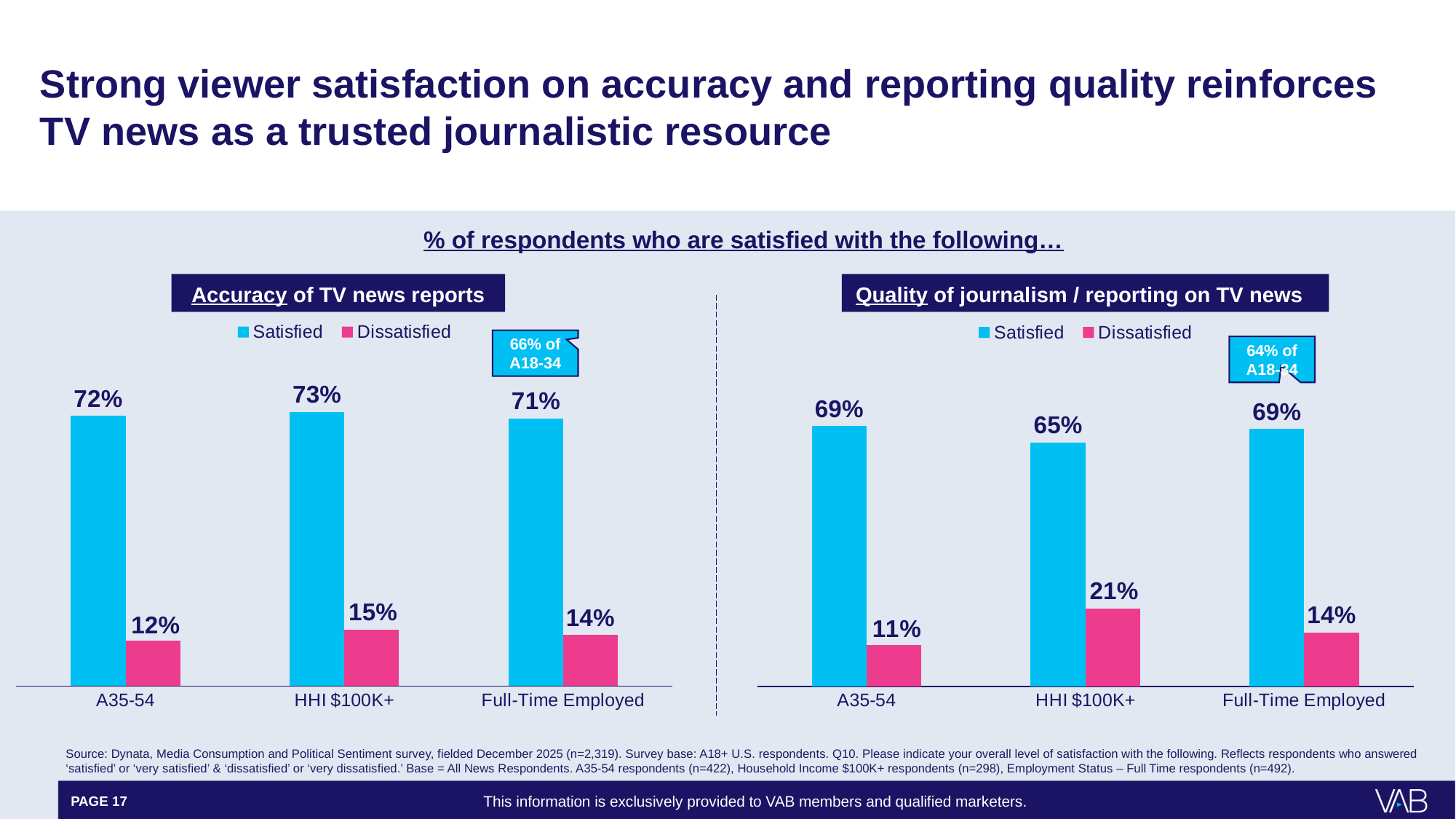
How many categories are shown on the x axis of the 'Accuracy of TV news reports' chart? 3 In the 'Accuracy of TV news reports' chart, which category has the highest Satisfied value? HHI $100K+ In the 'Accuracy of TV news reports' chart, what is the Dissatisfied value for A35-54? 12% In the 'Quality of journalism / reporting on TV news' chart, what is the Satisfied value for Full-Time Employed? 69% In the 'Quality of journalism / reporting on TV news' chart, which category has the lowest Satisfied value? HHI $100K+ In the 'Quality of journalism / reporting on TV news' chart, what is the difference between the Satisfied and Dissatisfied values for A35-54? 58 percentage points In the 'Quality of journalism / reporting on TV news' chart, what is the Dissatisfied value for HHI $100K+? 21% What kind of chart is the 'Accuracy of TV news reports' chart? Bar chart In the 'Accuracy of TV news reports' chart, what value does the callout give for A18-34? 66% How many series does the legend of the 'Quality of journalism / reporting on TV news' chart list? 2 In the 'Accuracy of TV news reports' chart, which is larger: the Dissatisfied value for HHI $100K+ or for Full-Time Employed? HHI $100K+ In the 'Accuracy of TV news reports' chart, what is the Satisfied value for HHI $100K+? 73%